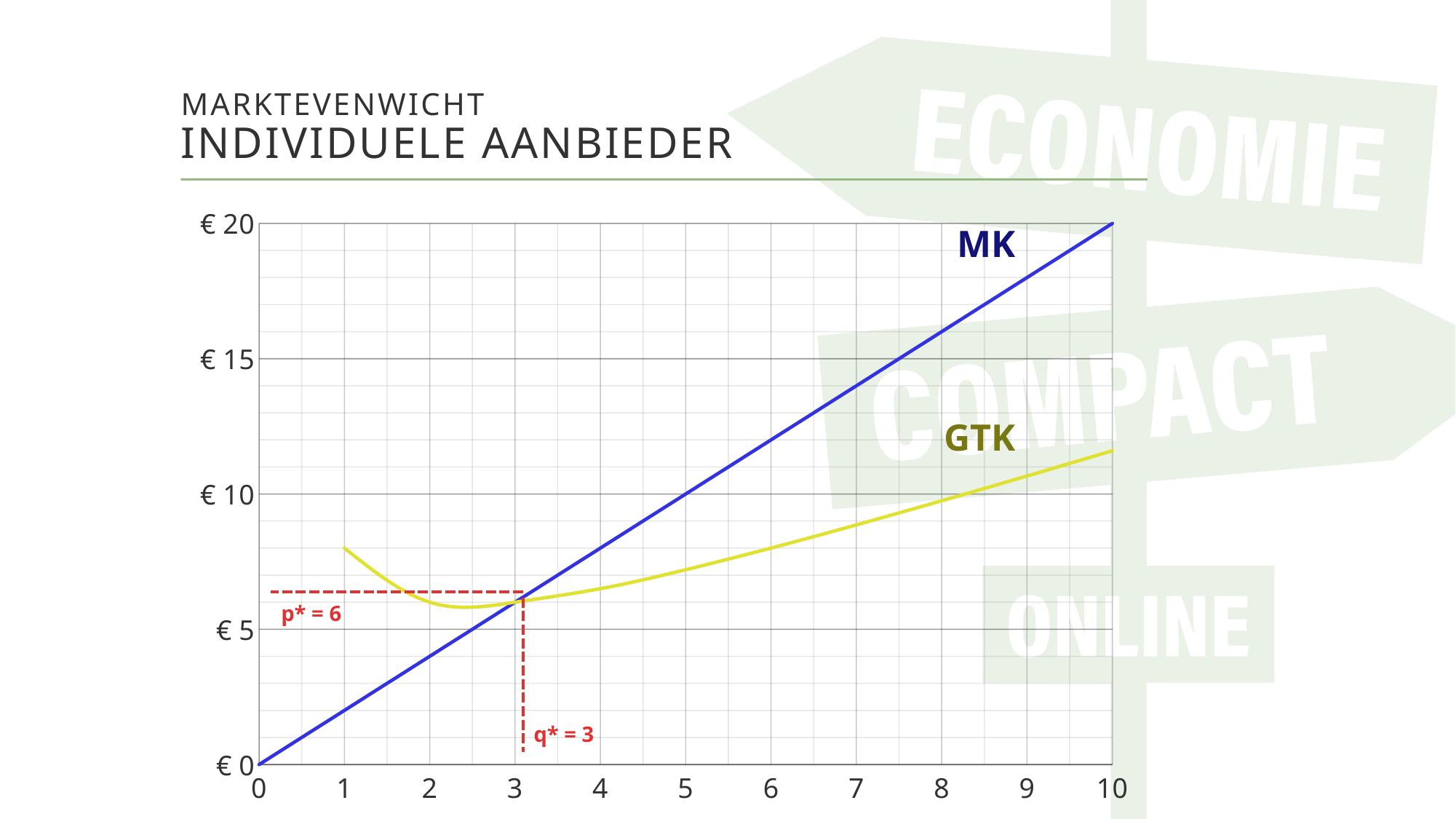
What is the equilibrium quantity q* marked on the chart? 3 What type of chart is shown on the slide? line chart What is the equilibrium price p* marked on the chart? 6 What is the value of MK at quantity 10? € 20 How many curves are labelled on the chart? 2 At quantity 8, which curve has the higher value, MK or GTK? MK Does the MK curve rise or fall as quantity increases? rise What colour is the MK line? blue Is the value of GTK at quantity 10 greater or less than € 15? less At quantity 1, which curve has the higher value, MK or GTK? GTK What is the value of MK at quantity 0? € 0 Is the value of MK at quantity 8 greater or less than € 15? greater